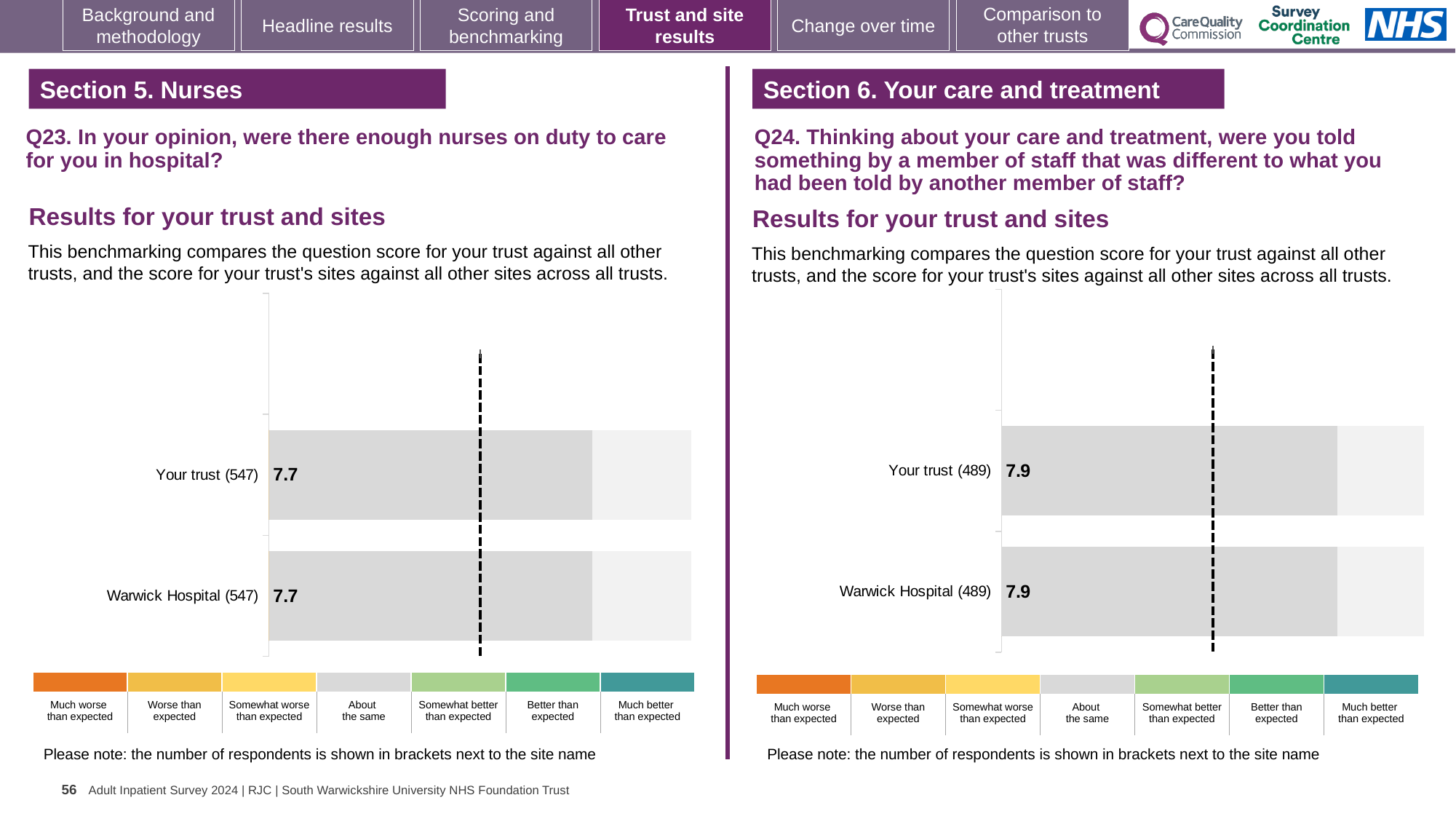
How many categories does the colour key below the Q24 chart on the right list? 7 In the Q24 chart on the right, what is the score for Your trust? 7.9 In the Q24 chart on the right, how many bars are plotted? 2 In the Q23 chart on the left, what is the score for Warwick Hospital? 7.7 In the Q23 chart on the left, what is the score for Your trust? 7.7 In the Q23 chart on the left, what is the difference between the score for Your trust and the score for Warwick Hospital? 0 In the Q23 chart on the left, how many respondents are shown in brackets for Warwick Hospital? 547 In the Q23 chart on the left, how many bars are plotted? 2 In the Q23 chart on the left, which benchmark category does the Your trust bar fall into according to the colour key? About the same In the Q24 chart on the right, what is the score for Warwick Hospital? 7.9 What kind of chart is the Q23 chart on the left? Bar chart In the Q24 chart on the right, how many respondents are shown in brackets for Your trust? 489